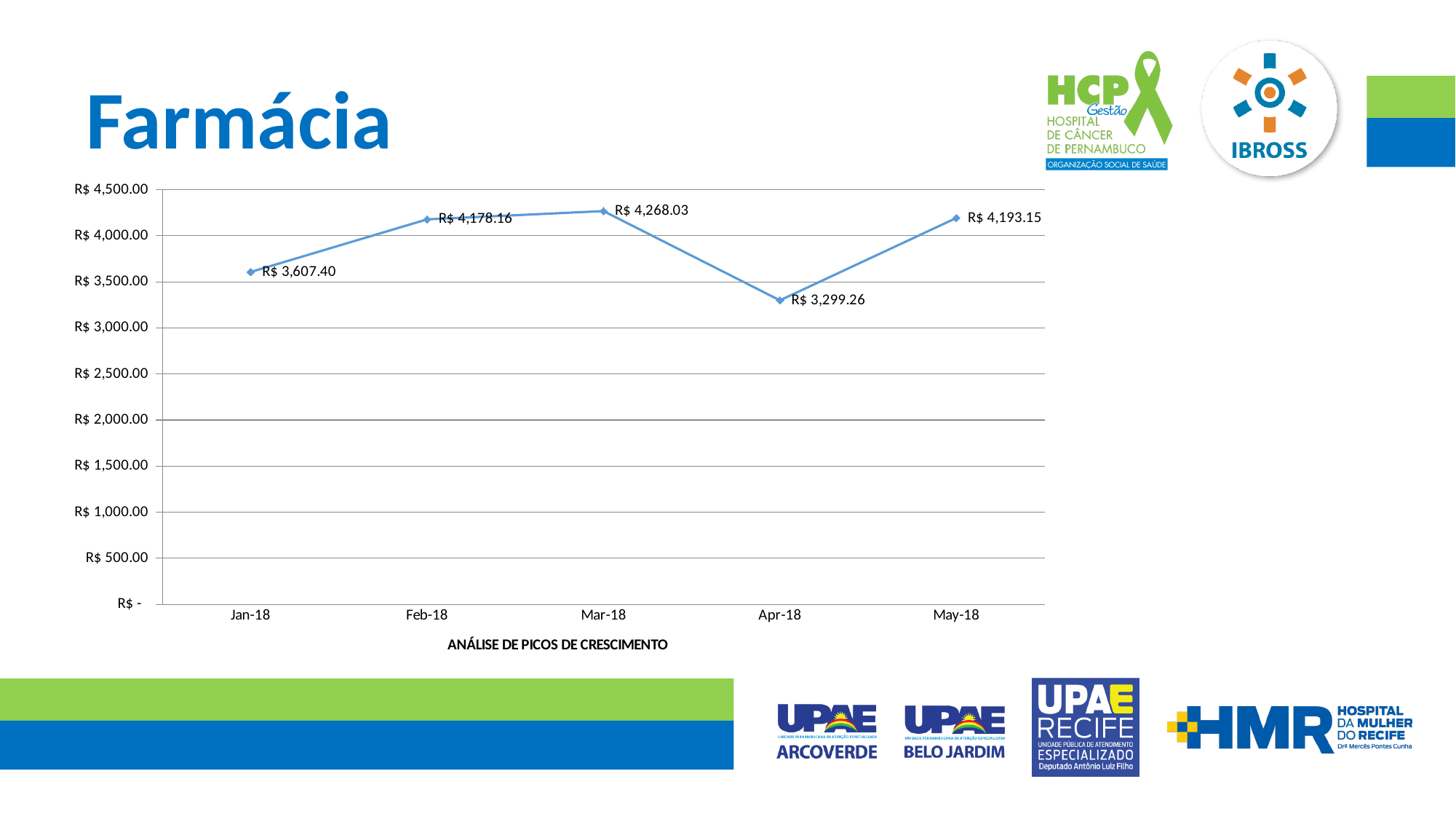
What is the value for Jan-18? R$ 3,607.40 What is the value for Apr-18? R$ 3,299.26 What is the difference between the values for Mar-18 and Apr-18? R$ 968.77 How many months are plotted on the chart? 5 What is the value for May-18? R$ 4,193.15 Which month has the lowest value? Apr-18 What is the title of the slide? Farmácia Is the value for Jan-18 greater or less than R$ 4,000.00? less Which month has the highest value? Mar-18 What is the difference between the values for Feb-18 and Jan-18? R$ 570.76 Which is larger, the value for Feb-18 or the value for May-18? May-18 What kind of chart is shown on the slide? line chart